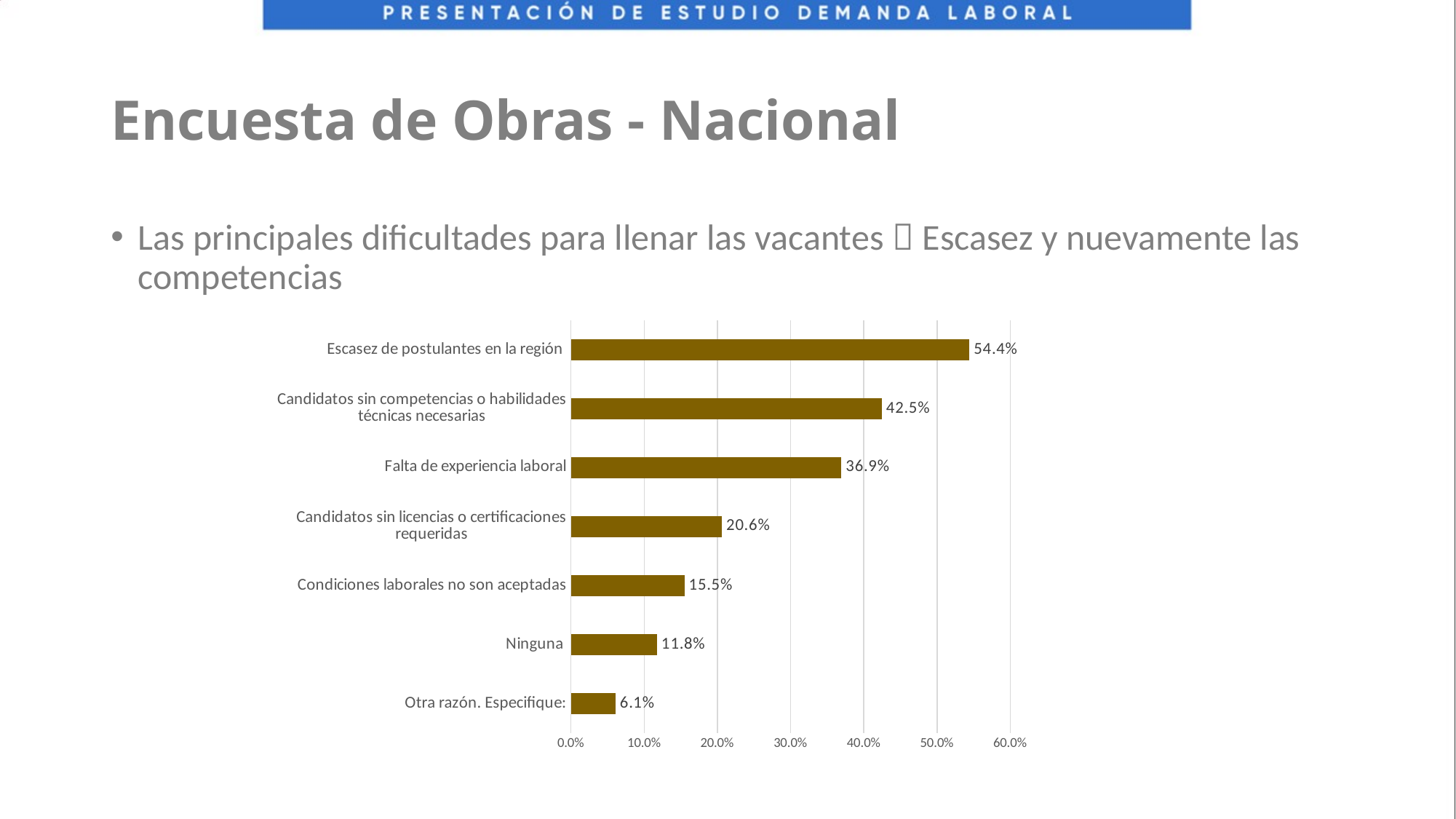
What is the difference between "Escasez de postulantes en la región" and "Candidatos sin competencias o habilidades técnicas necesarias"? 11.9% What is the difference between "Condiciones laborales no son aceptadas" and "Ninguna"? 3.7% What is the value for "Escasez de postulantes en la región"? 54.4% What is the value for "Ninguna"? 11.8% Which category has the lowest value? Otra razón. Especifique: How many categories are shown in the chart? 7 What kind of chart is shown on the slide? Bar chart Which is larger, "Falta de experiencia laboral" or "Candidatos sin licencias o certificaciones requeridas"? Falta de experiencia laboral What is the value for "Candidatos sin licencias o certificaciones requeridas"? 20.6% What is the value for "Falta de experiencia laboral"? 36.9% Is the value for "Candidatos sin competencias o habilidades técnicas necesarias" greater or less than 40.0%? greater Which category has the highest value? Escasez de postulantes en la región